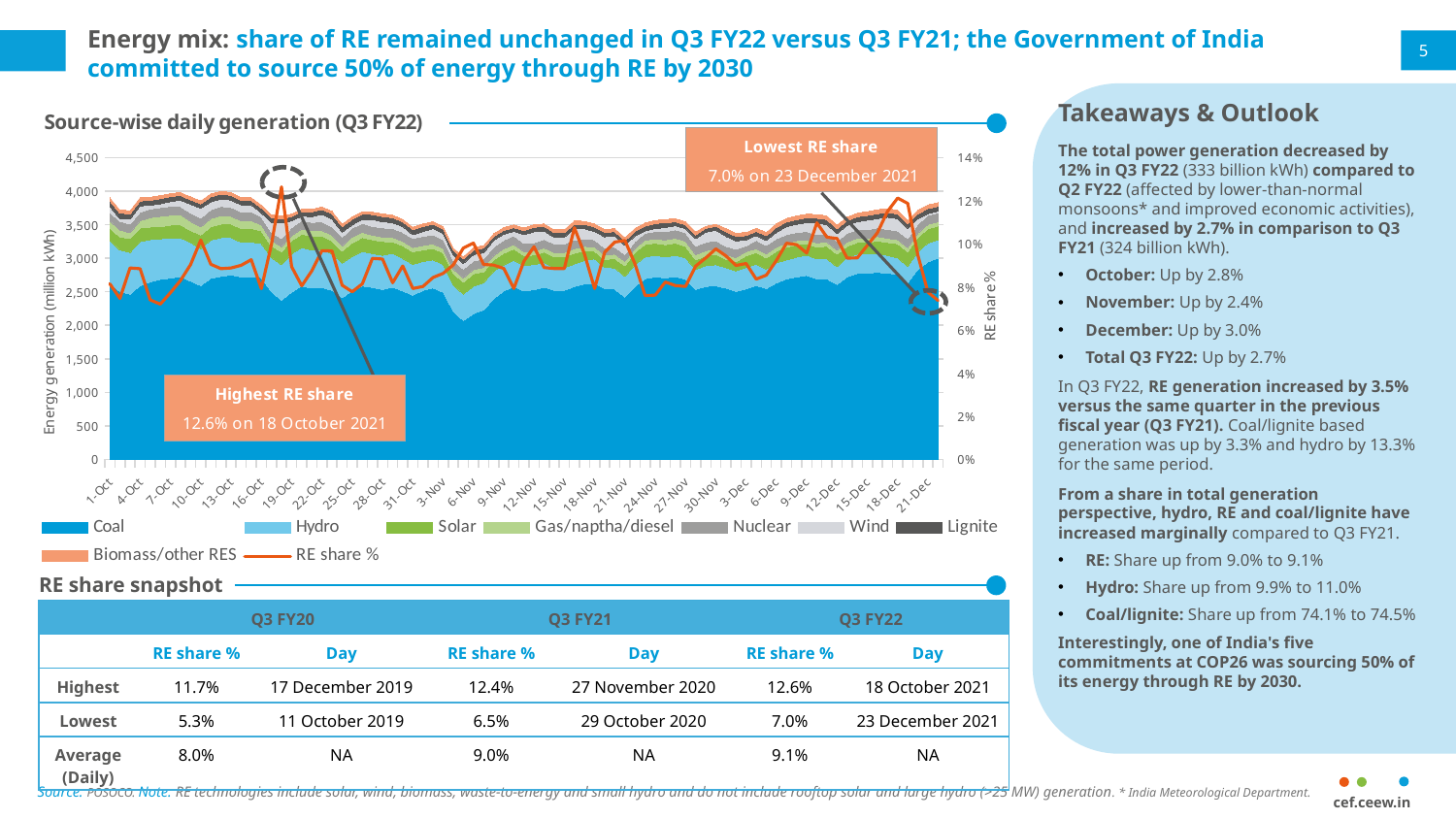
What is the difference between the highest and lowest RE share values shown on the chart? 5.6 percentage points On which date did the lowest RE share occur according to the chart callout? 23 December 2021 Was the RE share larger on 18 October 2021 or on 23 December 2021? 18 October 2021 What is the title of the chart on the slide? Source-wise daily generation (Q3 FY22) How many series does the chart legend list? 9 Which energy source contributes the largest share of daily generation in the chart? Coal What was the highest RE share shown on the chart? 12.6% On which date did the highest RE share occur according to the chart callout? 18 October 2021 What is the label of the left vertical axis of the chart? Energy generation (million kWh) What was the lowest RE share shown on the chart? 7.0% Is the total energy generation on 1-Oct greater or less than 3,000 million kWh? greater What kind of chart is used to show source-wise daily generation? Stacked area chart with a line for RE share %